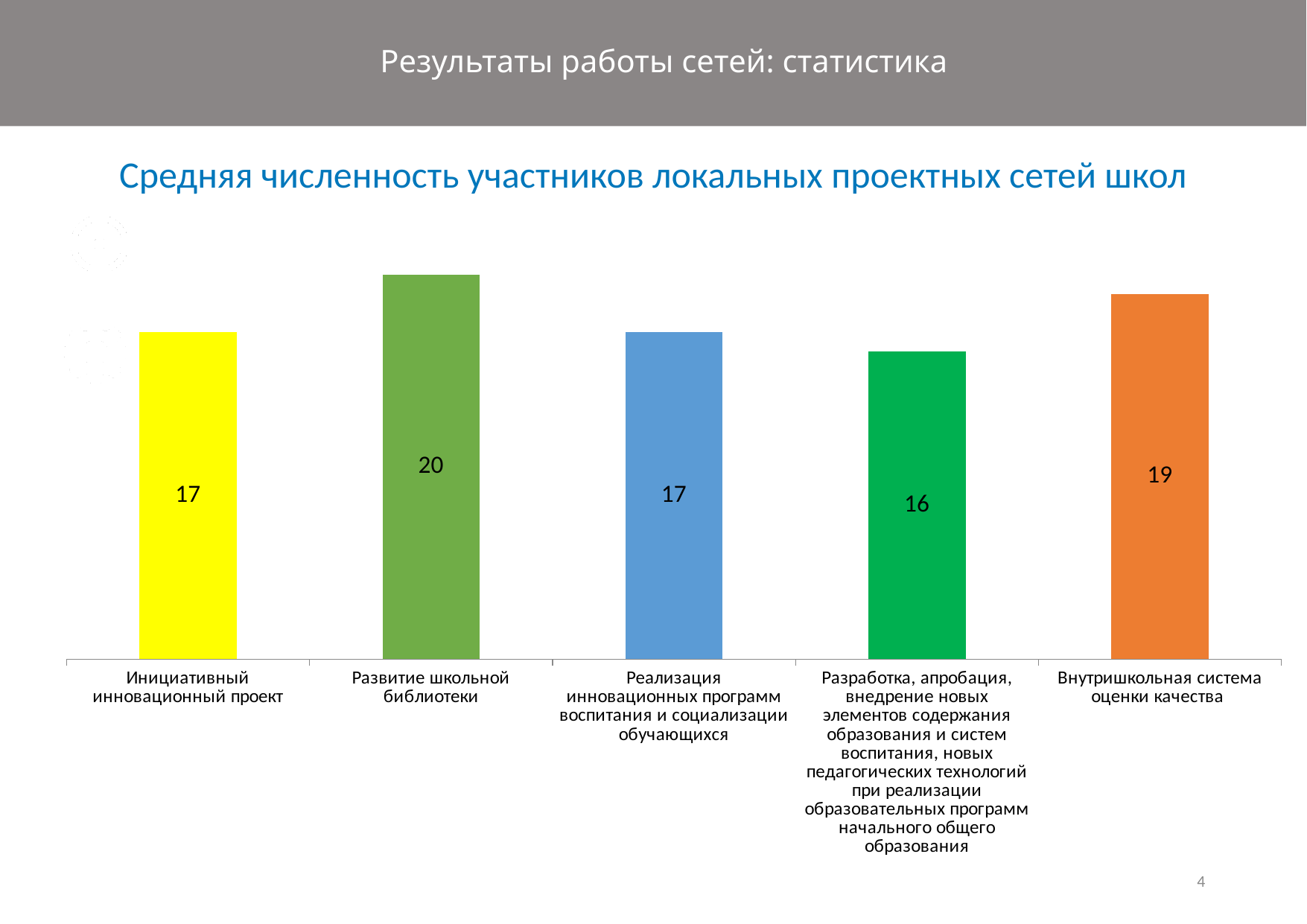
What is the title of the chart? Средняя численность участников локальных проектных сетей школ What kind of chart is shown on the slide? Bar chart What is the value for «Инициативный инновационный проект»? 17 What is the value for «Внутришкольная система оценки качества»? 19 How many categories are shown in the chart? 5 What is the difference between the values for «Развитие школьной библиотеки» and «Внутришкольная система оценки качества»? 1 What is the value for «Развитие школьной библиотеки»? 20 What is the value for «Реализация инновационных программ воспитания и социализации обучающихся»? 17 Which category has the highest value? Развитие школьной библиотеки What is the difference between the highest and lowest values in the chart? 4 Which is larger: the value for «Внутришкольная система оценки качества» or the value for «Инициативный инновационный проект»? Внутришкольная система оценки качества Which category has the lowest value? Разработка, апробация, внедрение новых элементов содержания образования и систем воспитания, новых педагогических технологий при реализации образовательных программ начального общего образования